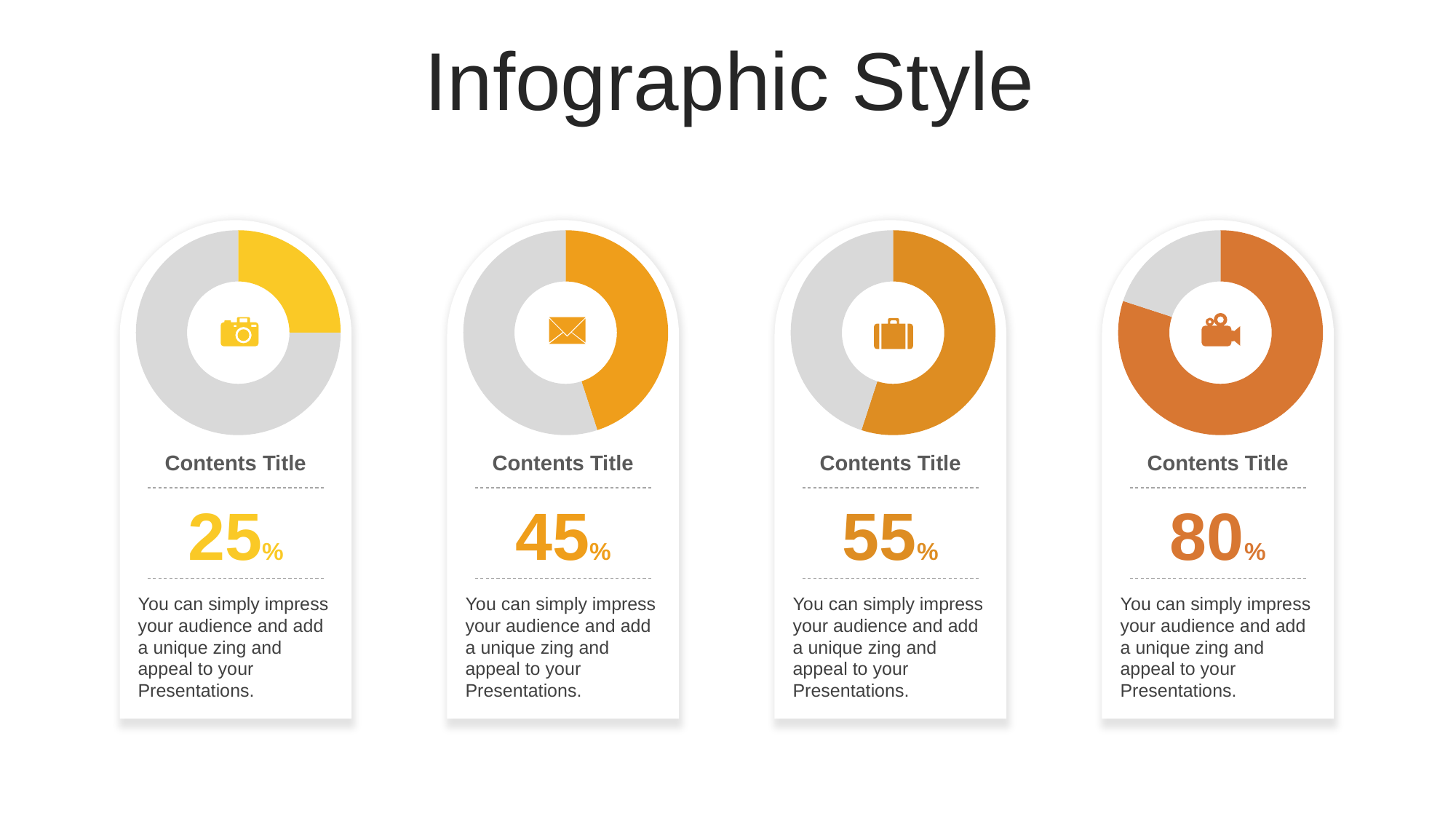
What percentage is shown for the third donut chart from the left (with the briefcase icon)? 55% Which of the four donut charts shows the lowest percentage? The leftmost chart (camera icon), 25% Which of the four donut charts shows the highest percentage? The rightmost chart (video camera icon), 80% What kind of chart is used for each of the four items on the slide? Donut chart What percentage is shown for the rightmost donut chart (with the video camera icon)? 80% How many donut charts are on the slide? 4 What is the difference between the percentage of the rightmost donut chart and the leftmost donut chart? 55% What percentage is shown for the leftmost donut chart (with the camera icon)? 25% Do the percentages increase or decrease moving from the leftmost chart to the rightmost chart? Increase Which shows a larger percentage: the second donut chart from the left or the third donut chart from the left? The third donut chart (55%) What percentage is shown for the second donut chart from the left (with the envelope icon)? 45% What is the difference between the percentages of the third and second donut charts from the left? 10%